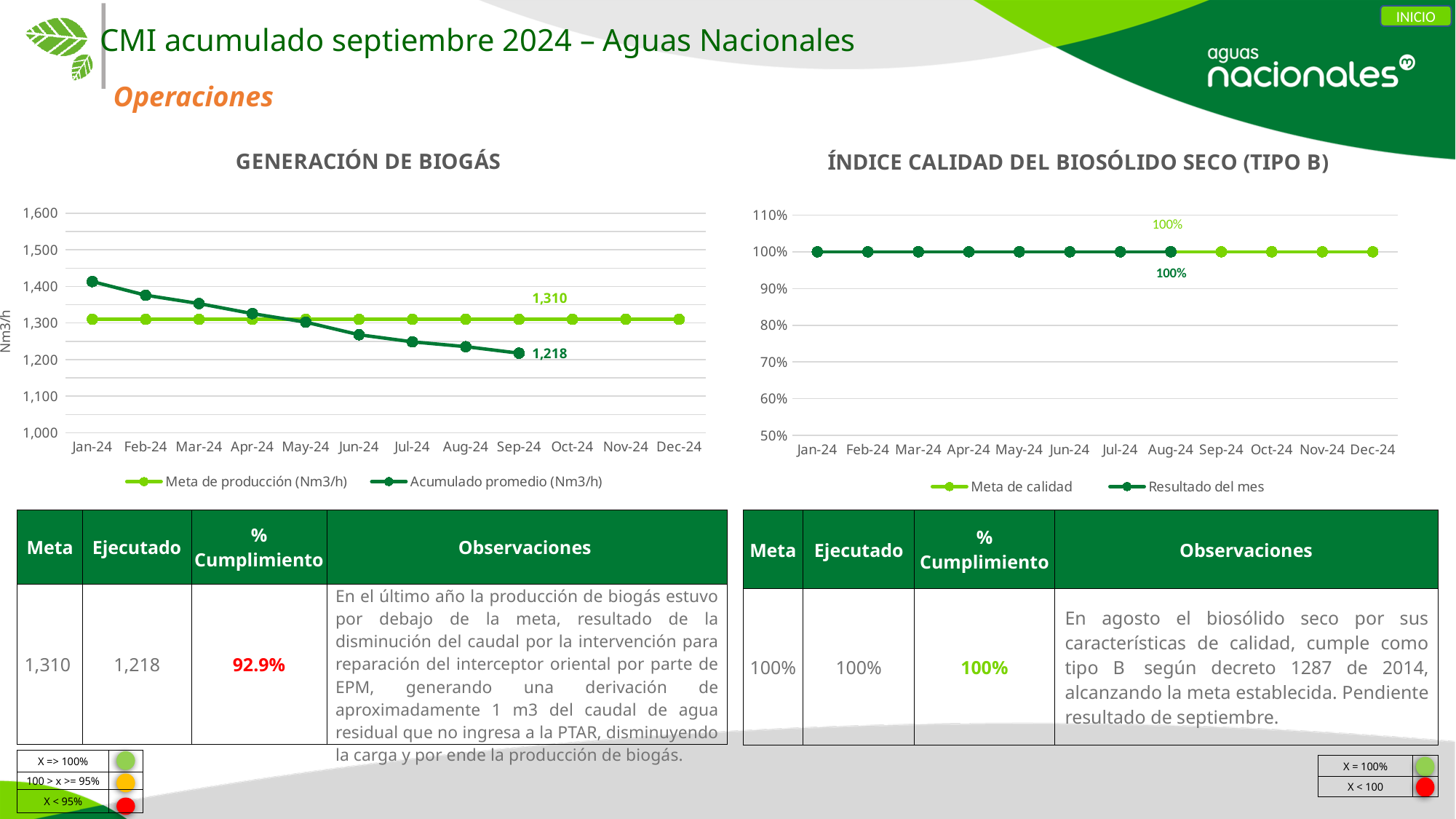
In the GENERACIÓN DE BIOGÁS chart, what is the labelled value of the Meta de producción (Nm3/h) line? 1,310 In the GENERACIÓN DE BIOGÁS chart, what kind of chart is used? Line chart In the GENERACIÓN DE BIOGÁS chart, what is the difference between the Meta de producción value (1,310) and the Acumulado promedio value at Sep-24 (1,218)? 92 In the GENERACIÓN DE BIOGÁS chart, how many months are shown on the x axis? 12 In the GENERACIÓN DE BIOGÁS chart, at Jan-24, which is larger: Acumulado promedio or Meta de producción? Acumulado promedio In the ÍNDICE CALIDAD DEL BIOSÓLIDO SECO (TIPO B) chart, what is the labelled value of the Meta de calidad line? 100% In the ÍNDICE CALIDAD DEL BIOSÓLIDO SECO (TIPO B) chart, what is the labelled value of Resultado del mes at Aug-24? 100% In the GENERACIÓN DE BIOGÁS chart, does the Acumulado promedio (Nm3/h) line rise or fall from Jan-24 to Sep-24? Fall In the GENERACIÓN DE BIOGÁS chart, is the Acumulado promedio value for Aug-24 greater or less than 1,300? less In the GENERACIÓN DE BIOGÁS chart, what is the labelled value of Acumulado promedio (Nm3/h) at Sep-24? 1,218 In the ÍNDICE CALIDAD DEL BIOSÓLIDO SECO (TIPO B) chart, how many months have a Resultado del mes point plotted? 8 In the GENERACIÓN DE BIOGÁS chart, how many series does the legend list? 2